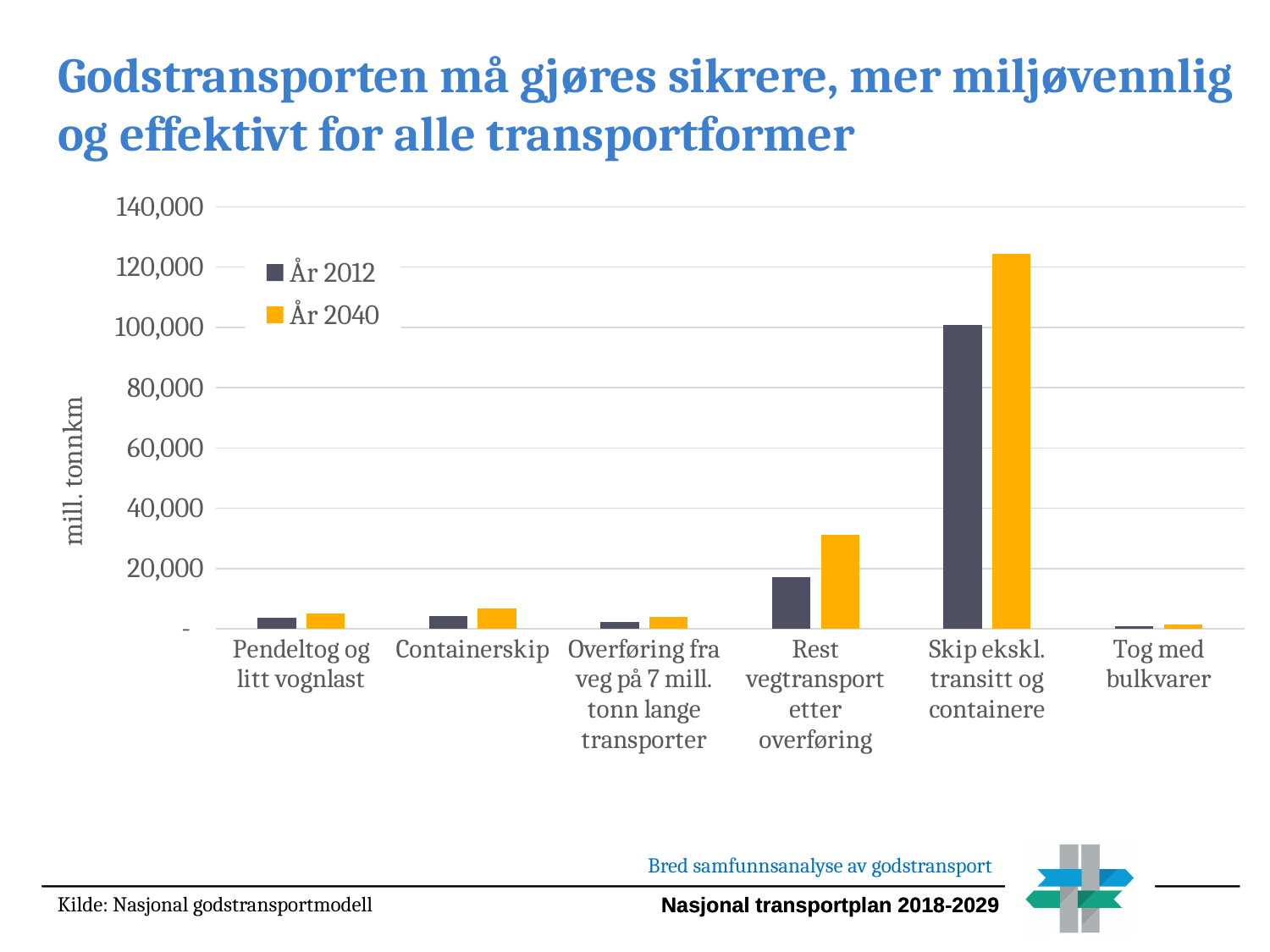
What is the label on the y axis of the chart? mill. tonnkm How many series does the legend list? 2 Is the År 2040 value for Skip ekskl. transitt og containere greater or less than 120,000? greater How many categories are shown on the x axis? 6 Is the År 2040 value for Rest vegtransport etter overføring greater or less than 20,000? greater For Skip ekskl. transitt og containere, which series has the larger value, År 2012 or År 2040? År 2040 Is the År 2012 value for Rest vegtransport etter overføring greater or less than 20,000? less Which has the larger År 2040 value, Containerskip or Rest vegtransport etter overføring? Rest vegtransport etter overføring What kind of chart is shown on the slide? bar chart Which category has the lowest value for År 2012? Tog med bulkvarer Which category has the highest value for År 2040? Skip ekskl. transitt og containere